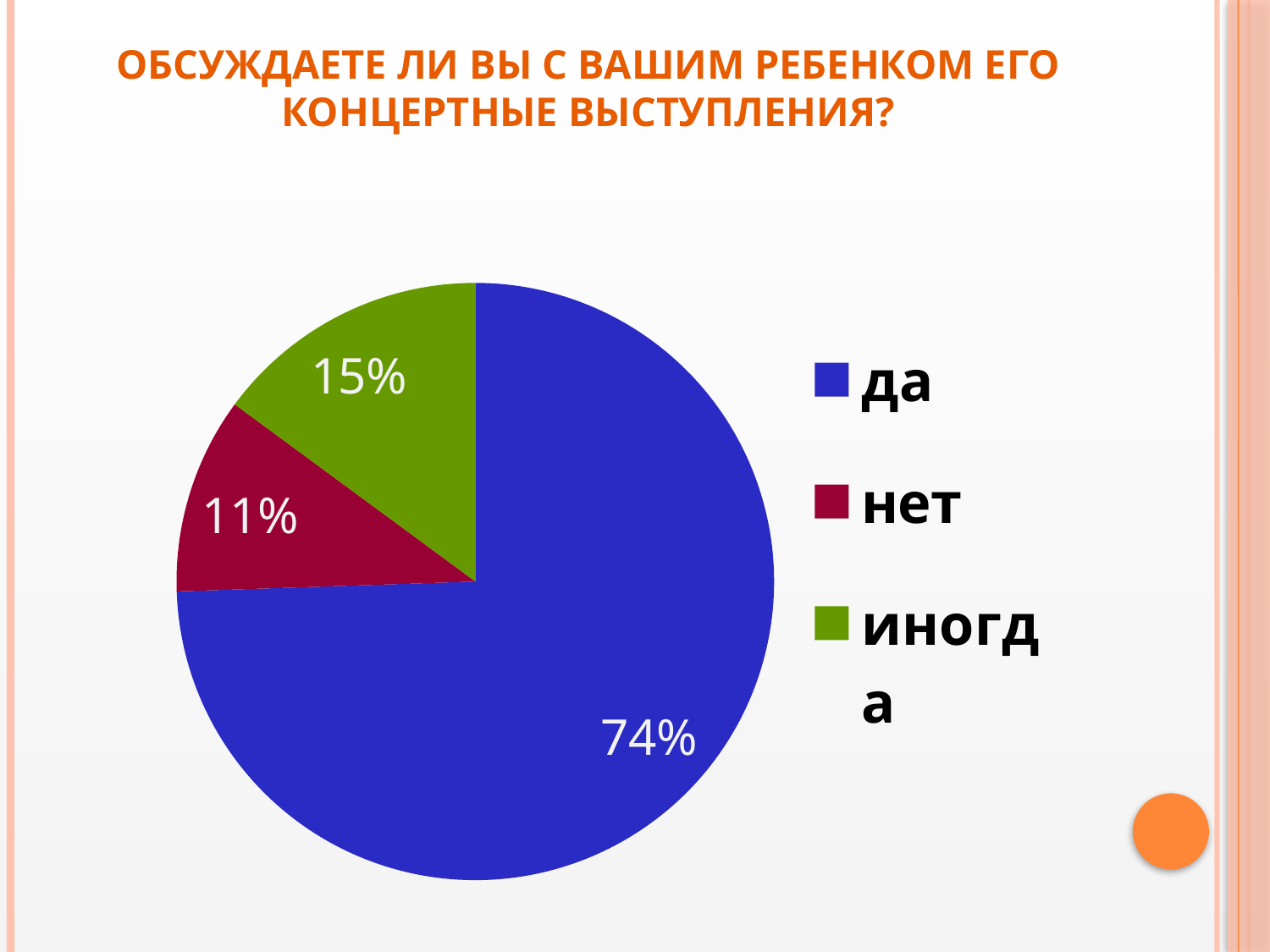
What is the difference in percentage points between the "да" and "иногда" slices? 59 Which is larger, the "иногда" slice or the "нет" slice? иногда What share of the pie does the "нет" slice represent? 11% Which category has the smallest slice of the pie? нет What colour is the "нет" slice in the pie chart? dark red What is the difference in percentage points between the "иногда" and "нет" slices? 4 What share of the pie does the "иногда" slice represent? 15% How many entries does the legend list? 3 What kind of chart is shown on the slide? pie chart Which category has the largest slice of the pie? да What share of the pie does the "да" slice represent? 74% How many slices does the pie chart have? 3